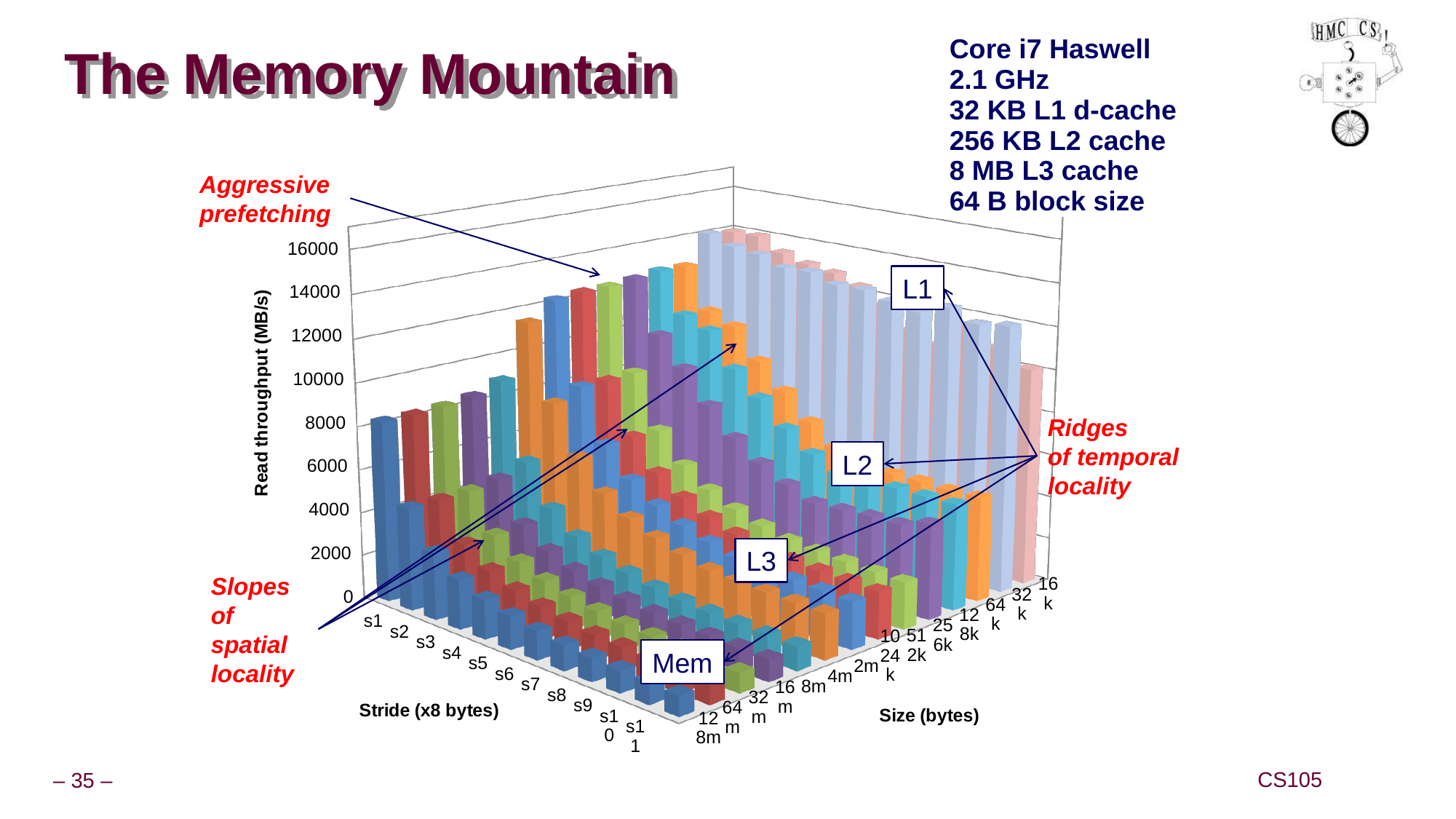
Which stride has the highest read throughput for the smallest sizes, s1 or s11? s1 What kind of chart is shown on the slide? 3D bar chart What quantity is plotted on the vertical axis of the chart? Read throughput (MB/s) Which region of the chart has higher read throughput, the L1 region or the Mem region? L1 What is the unit of the stride axis as labelled on the chart? x8 bytes How many stride categories (s1 through s11) are shown on the stride axis? 11 What is the lowest tick value shown on the read throughput axis? 0 What is the highest tick value shown on the read throughput axis? 16000 What is the title of the slide's chart? The Memory Mountain For stride s1, does read throughput rise or fall as the working-set size decreases from 128m toward 16k? rise For a fixed size, does read throughput generally rise or fall as the stride increases from s1 to s11? fall